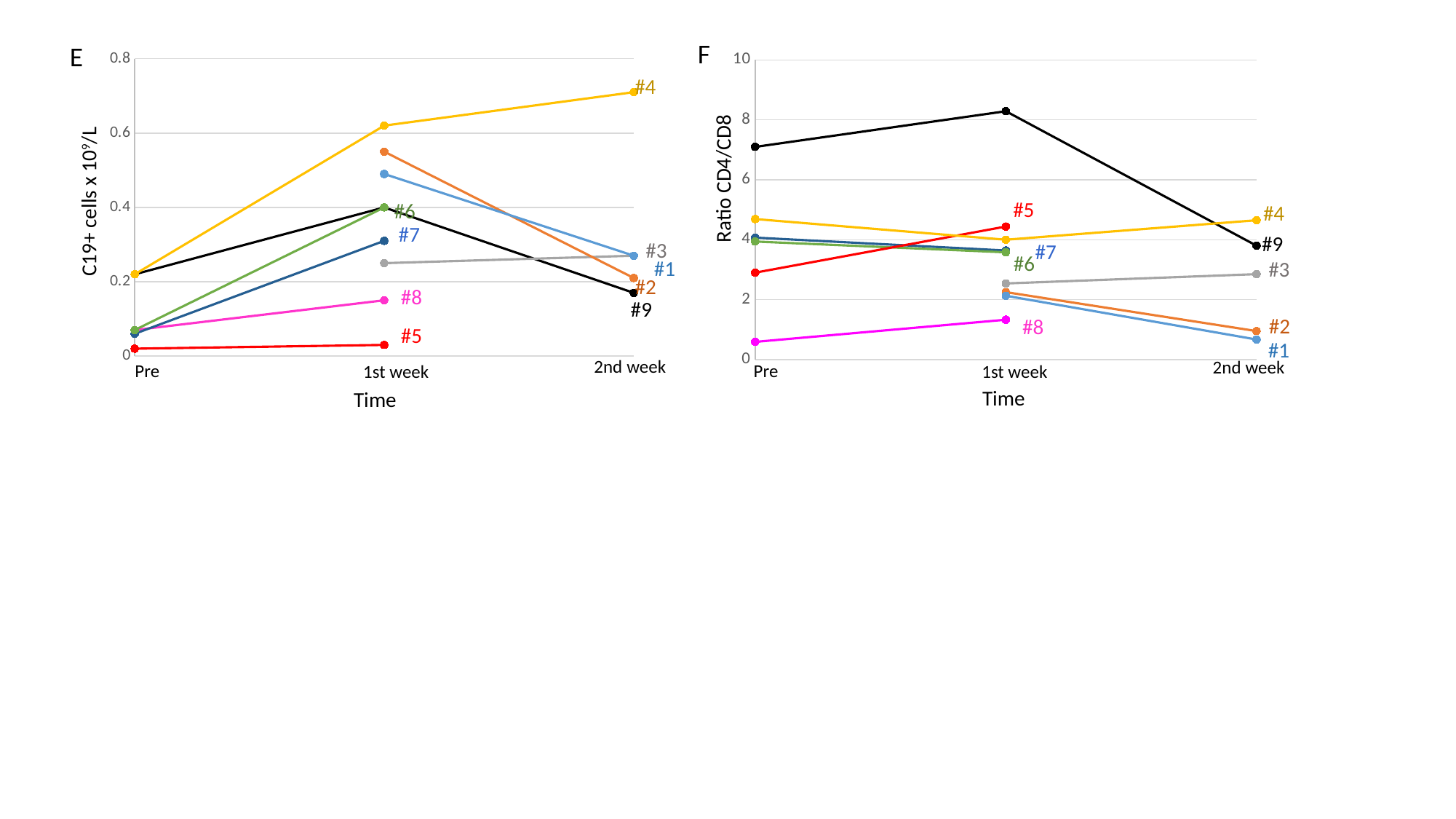
How many time points are shown on the x axis of chart F (right)? 3 What kind of chart is chart E (left)? line chart In chart F (right), is the value for #9 at Pre greater or less than 6? greater In chart E (left), is the value for #5 at 1st week greater or less than 0.2? less In chart E (left), which series has the lowest value at 1st week? #5 In chart E (left), is the value for #4 at 2nd week greater or less than 0.6? greater In chart F (right), does the value for #9 rise or fall from 1st week to 2nd week? fall In chart E (left), at 1st week, which is larger: #4 or #2? #4 In chart F (right), which series has the lowest value at Pre? #8 How many labelled patient series are plotted in chart E (left)? 9 In chart F (right), which series has the highest value at Pre? #9 In chart E (left), which series has the highest value at 2nd week? #4